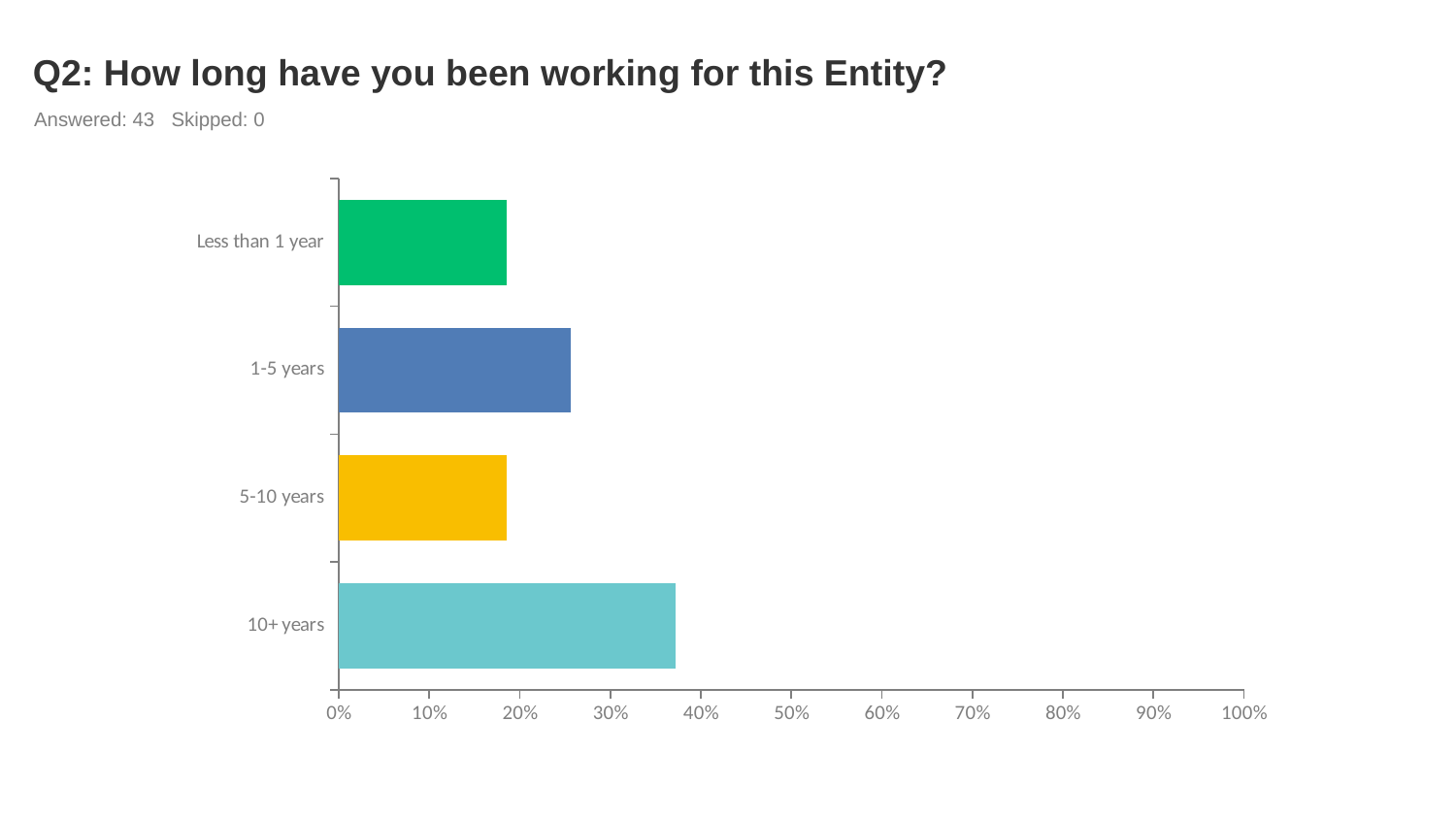
Is the value for 10+ years greater or less than 30%? greater How many categories are shown on the chart? 4 Is the value for 10+ years greater or less than 40%? less Which category has the highest value? 10+ years Is the value for 1-5 years greater or less than 20%? greater What kind of chart is shown on the slide? bar chart Which is larger, the value for 10+ years or the value for Less than 1 year? 10+ years Which is larger, the value for 1-5 years or the value for 5-10 years? 1-5 years What is the title of the chart? Q2: How long have you been working for this Entity?